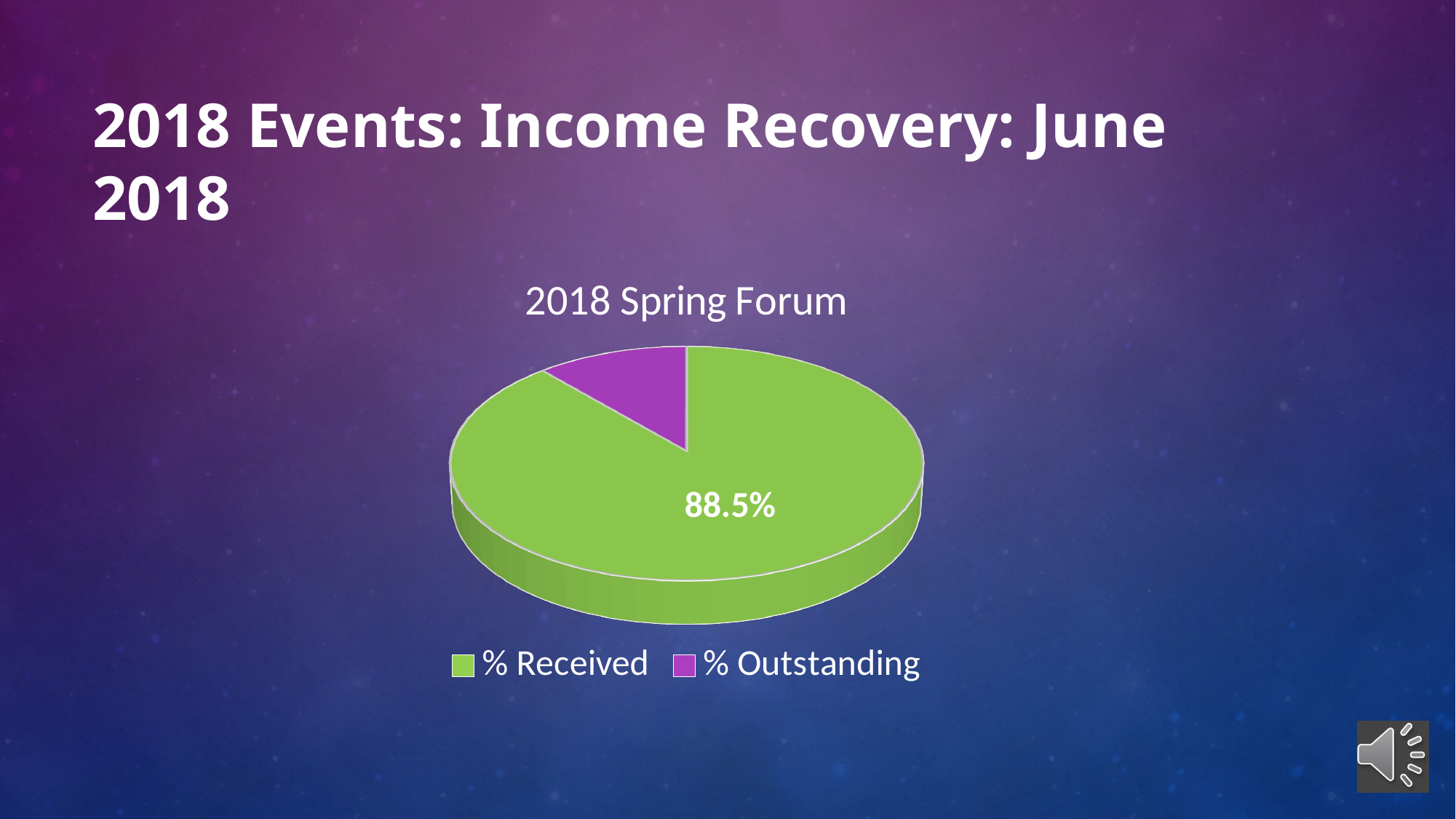
What share of the pie does the % Received slice take? 88.5% What is the title of the chart? 2018 Spring Forum What colour is the % Outstanding slice? purple How many slices does the pie chart have? 2 Which is larger, % Received or % Outstanding? % Received Which slice is the largest in the 2018 Spring Forum pie chart? % Received What kind of chart is shown on the slide? pie chart Which slice is the smallest in the 2018 Spring Forum pie chart? % Outstanding How many entries does the legend list? 2 What percentage is shown for % Received in the 2018 Spring Forum pie chart? 88.5%